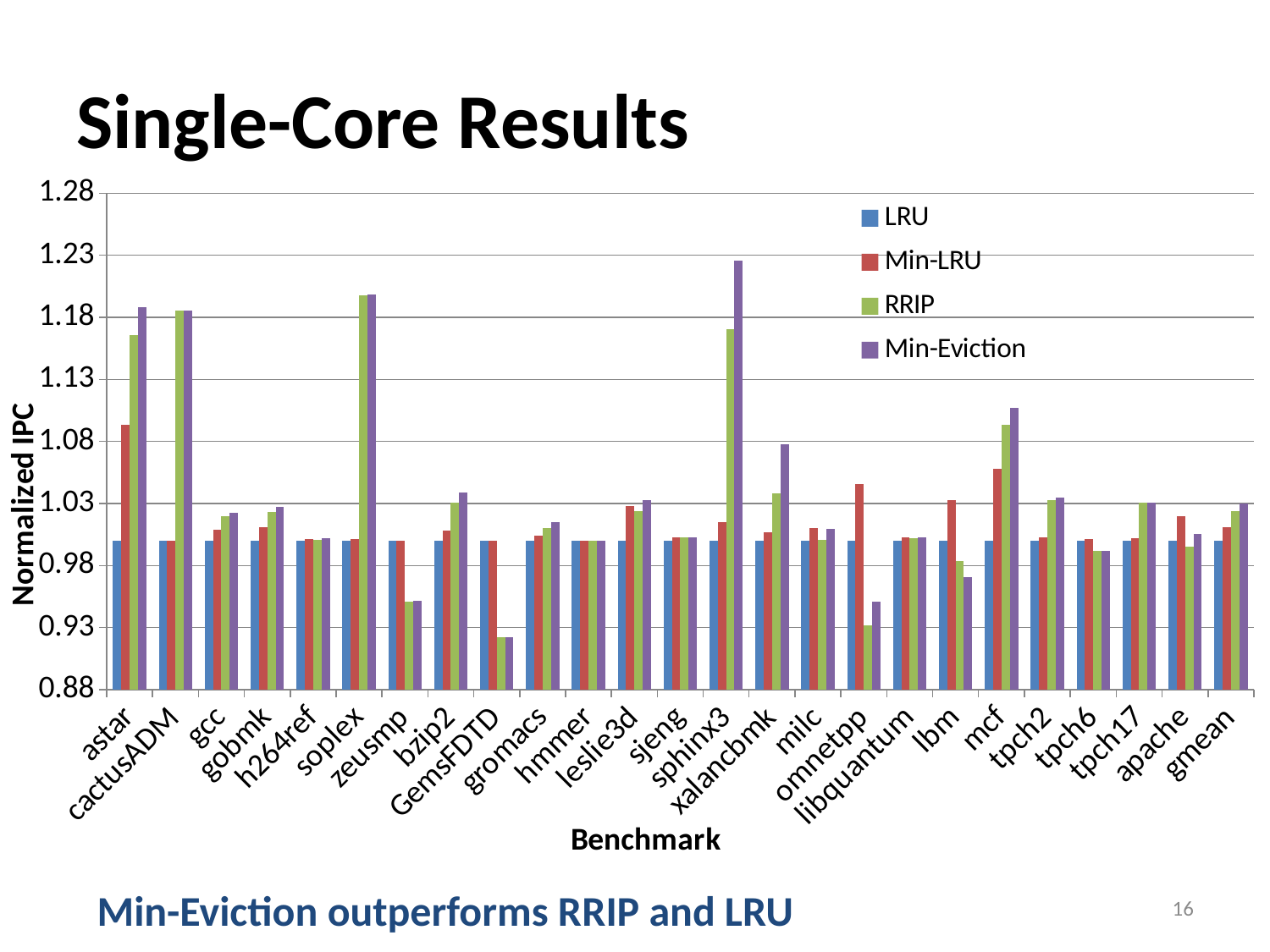
How many benchmark categories are shown on the x axis? 25 For xalancbmk, which is larger: the Min-Eviction value or the RRIP value? Min-Eviction Is the Min-Eviction value for sphinx3 greater or less than 1.18? greater For omnetpp, which is larger: the Min-LRU value or the RRIP value? Min-LRU Which benchmark has the highest Min-Eviction value? sphinx3 Is the Min-LRU value for omnetpp greater or less than 1.03? greater How many series does the legend list? 4 What is the title of the y axis? Normalized IPC Is the Min-Eviction value for mcf greater or less than 1.08? greater What kind of chart is shown on the slide? bar chart Which benchmark has the lowest RRIP value? GemsFDTD